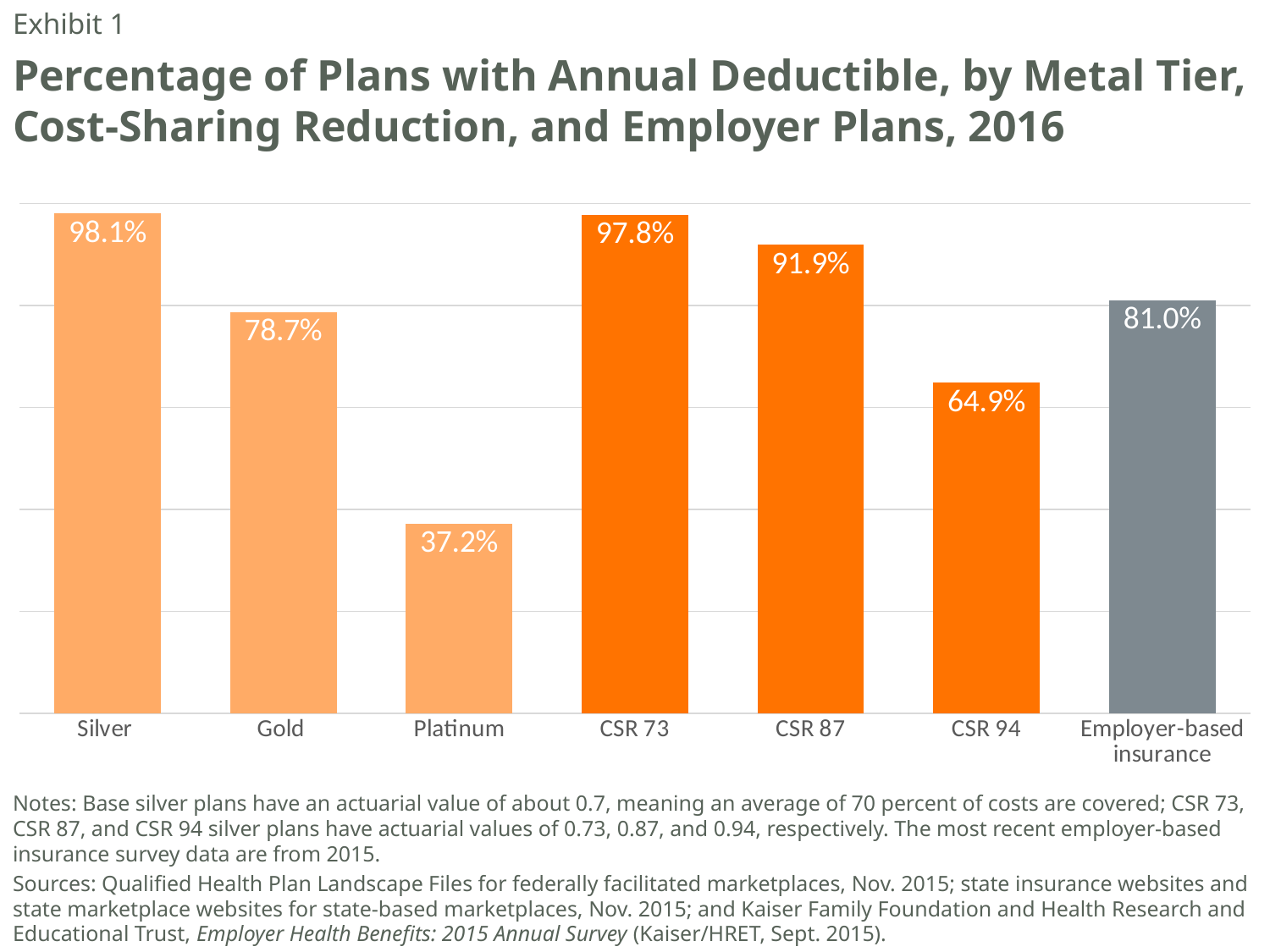
What percentage of Silver plans have an annual deductible? 98.1% What is the difference in percentage points between Gold and Platinum plans? 41.5 What percentage of CSR 94 plans have an annual deductible? 64.9% Which category has the highest percentage of plans with an annual deductible? Silver What is the value for Employer-based insurance? 81.0% How many categories are shown on the x axis? 7 What kind of chart is shown on the slide? Bar chart Which is larger, the value for Gold or the value for Employer-based insurance? Employer-based insurance Do the values rise or fall from CSR 73 to CSR 94? Fall Which category has the lowest percentage of plans with an annual deductible? Platinum What is the difference in percentage points between CSR 73 and CSR 87 plans? 5.9 What is the value shown for Platinum plans? 37.2%